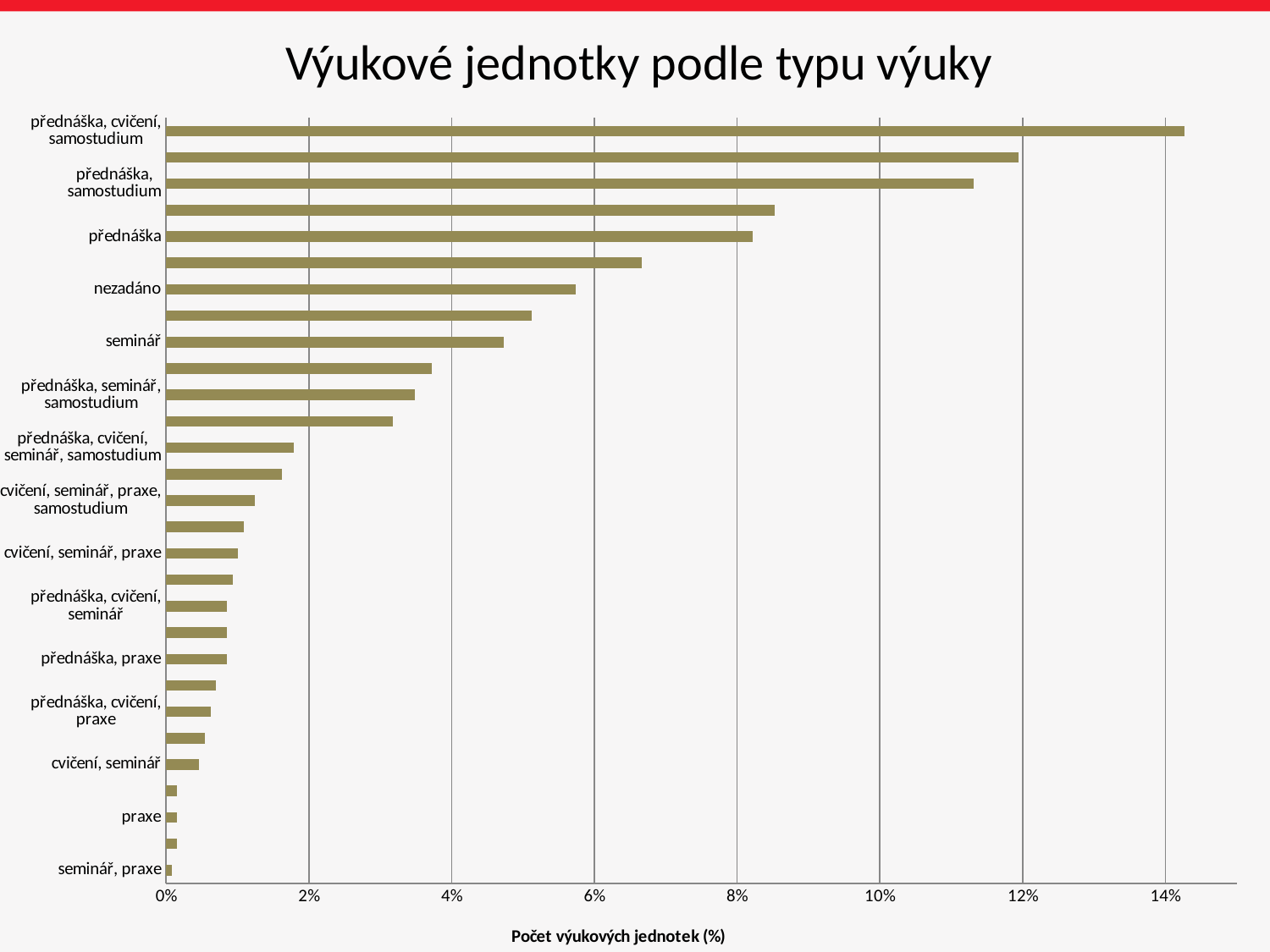
Is the value for 'přednáška, cvičení, samostudium' greater or less than 12%? greater Do the bar values increase or decrease going from the top of the chart to the bottom? decrease What is the label of the horizontal axis? Počet výukových jednotek (%) What is the title of the chart? Výukové jednotky podle typu výuky What kind of chart is shown on the slide? bar chart Is the value for 'přednáška, seminář, samostudium' greater or less than 4%? less Which category has the longest bar? přednáška, cvičení, samostudium Is the value for 'cvičení, seminář' greater or less than 2%? less Which has a larger value, 'přednáška' or 'nezadáno'? přednáška